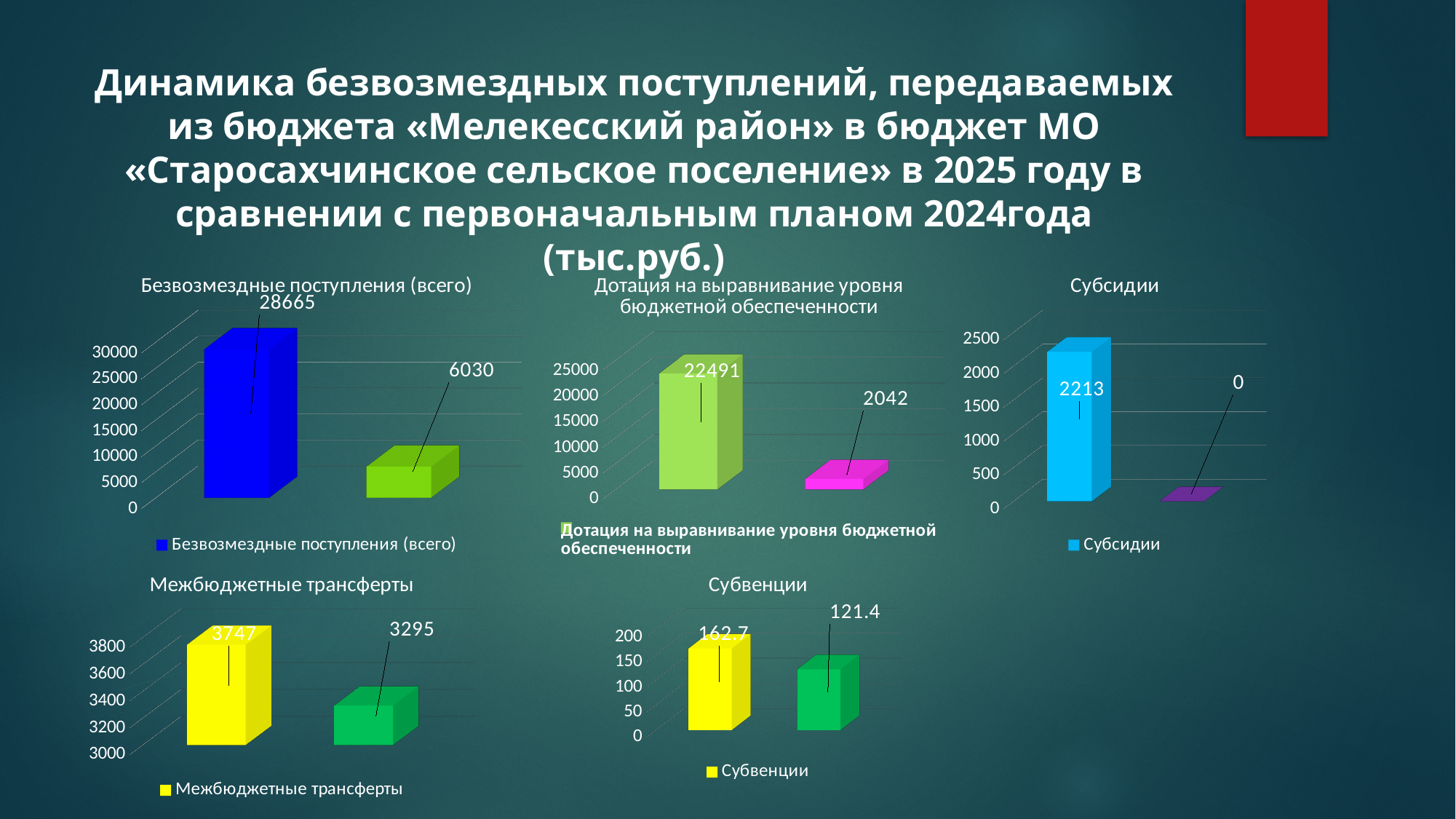
In the chart titled «Безвозмездные поступления (всего)», what value is printed on the left (blue) bar? 28665 How many charts are shown on the slide? 5 In the chart titled «Межбюджетные трансферты», what value is printed on the left (yellow) bar? 3747 In the chart titled «Субвенции», do the values rise or fall from the left bar to the right bar? fall In the chart titled «Безвозмездные поступления (всего)», what is the difference between the two bar values? 22635 In the chart titled «Субсидии», what value is printed on the right (purple) bar? 0 In the chart titled «Субсидии», which bar is higher, the left (light blue) one or the right (purple) one? the left (light blue) one In the chart titled «Дотация на выравнивание уровня бюджетной обеспеченности», what value is printed on the right (pink) bar? 2042 In the chart titled «Межбюджетные трансферты», what is the difference between the two bar values? 452 In the chart titled «Безвозмездные поступления (всего)», what value is printed on the right (green) bar? 6030 In the chart titled «Субвенции», what value is printed on the right (green) bar? 121.4 In the chart titled «Дотация на выравнивание уровня бюджетной обеспеченности», what value is printed on the left (light green) bar? 22491